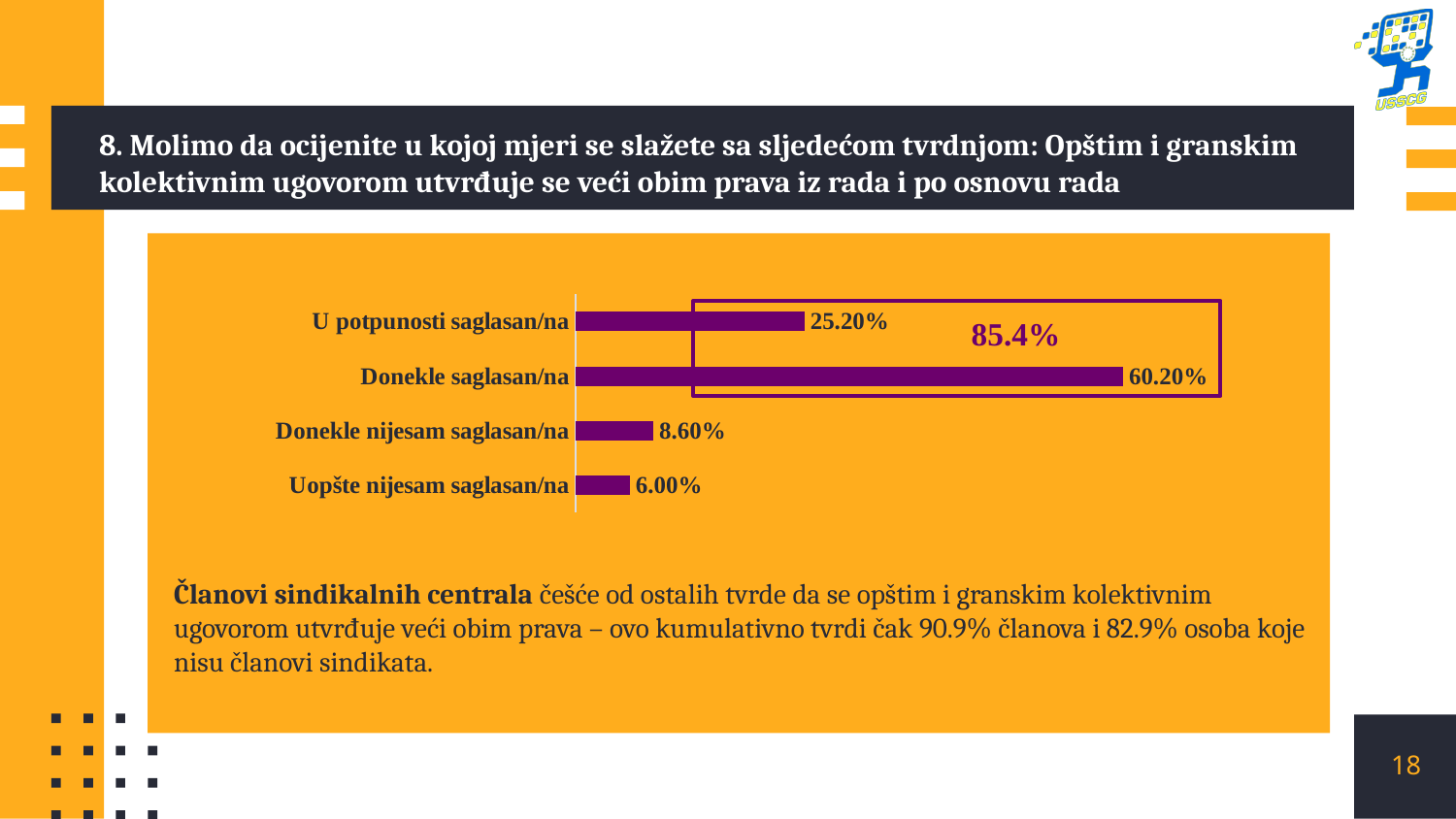
What is the value for "U potpunosti saglasan/na"? 25.20% What is the value for "Donekle saglasan/na"? 60.20% What is the value for "Uopšte nijesam saglasan/na"? 6.00% What kind of chart is shown on the slide? Bar chart Which category has the highest value? Donekle saglasan/na How many categories are shown in the chart? 4 What is the difference between the values for "Donekle saglasan/na" and "U potpunosti saglasan/na"? 35.00% What is the total of the values for "Donekle nijesam saglasan/na" and "Uopšte nijesam saglasan/na"? 14.60% Which category has the lowest value? Uopšte nijesam saglasan/na Which is larger, the value for "Donekle nijesam saglasan/na" or "Uopšte nijesam saglasan/na"? Donekle nijesam saglasan/na What is the value for "Donekle nijesam saglasan/na"? 8.60% What combined percentage is shown in the box around the two "saglasan/na" bars? 85.4%